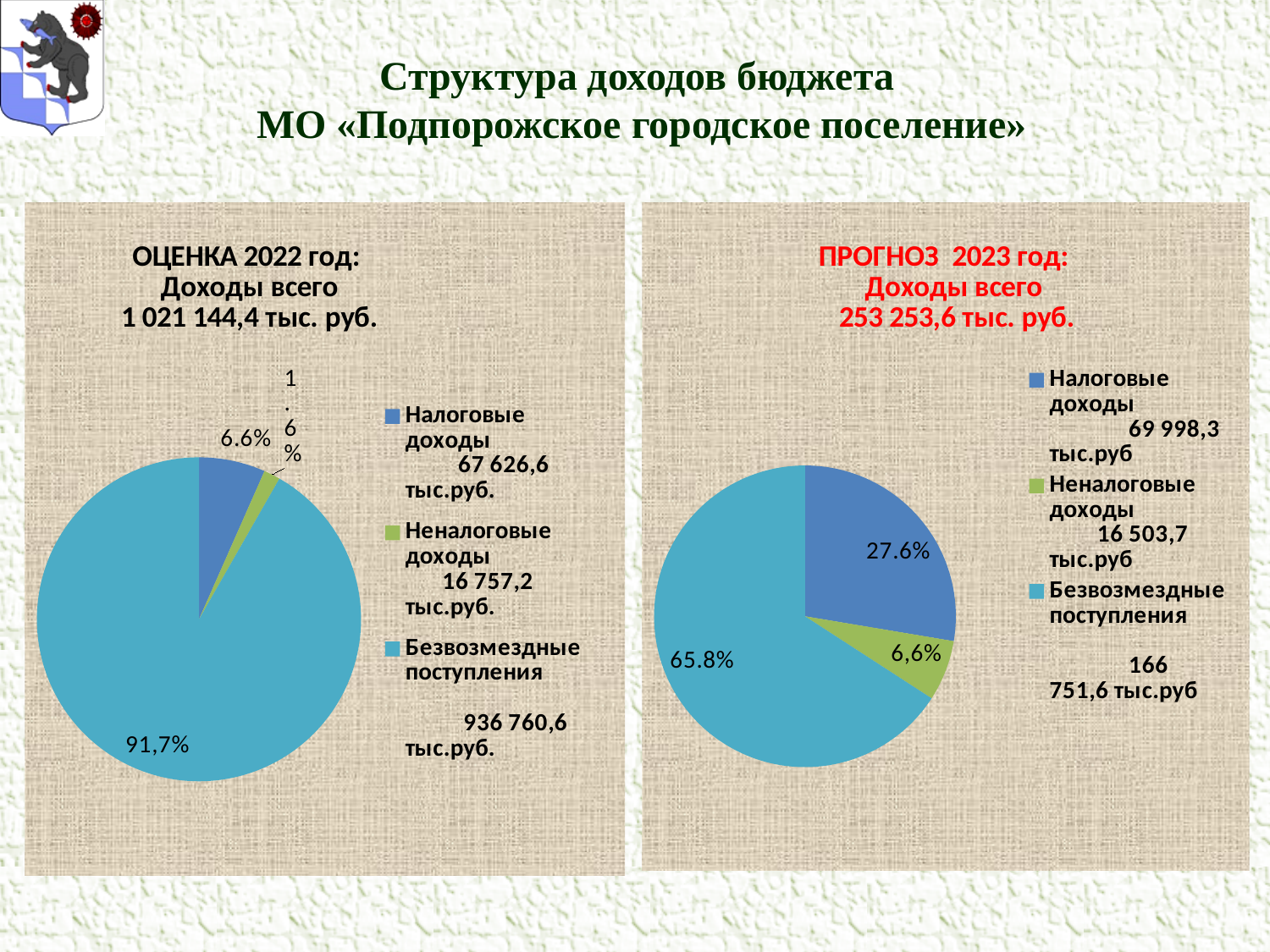
In the left chart (ОЦЕНКА 2022 год), what value in тыс.руб. does the legend give for Неналоговые доходы? 16 757,2 тыс.руб. In the left chart (ОЦЕНКА 2022 год), what percentage share is labelled for Безвозмездные поступления? 91,7% In the left chart (ОЦЕНКА 2022 год), which category has the smallest slice? Неналоговые доходы In the left chart (ОЦЕНКА 2022 год), what percentage share is labelled for Налоговые доходы? 6.6% In the right chart (ПРОГНОЗ 2023 год), what percentage share is labelled for Безвозмездные поступления? 65.8% In the right chart (ПРОГНОЗ 2023 год), which category has the largest slice? Безвозмездные поступления What total income (Доходы всего) is stated in the title of the right chart (ПРОГНОЗ 2023 год)? 253 253,6 тыс. руб. In the right chart (ПРОГНОЗ 2023 год), what value in тыс.руб does the legend give for Неналоговые доходы? 16 503,7 тыс.руб How many categories does the legend of the right chart (ПРОГНОЗ 2023 год) list? 3 What type of chart is used on the left (ОЦЕНКА 2022 год) side of the slide? pie chart In the left chart (ОЦЕНКА 2022 год), what value in тыс.руб. does the legend give for Налоговые доходы? 67 626,6 тыс.руб.